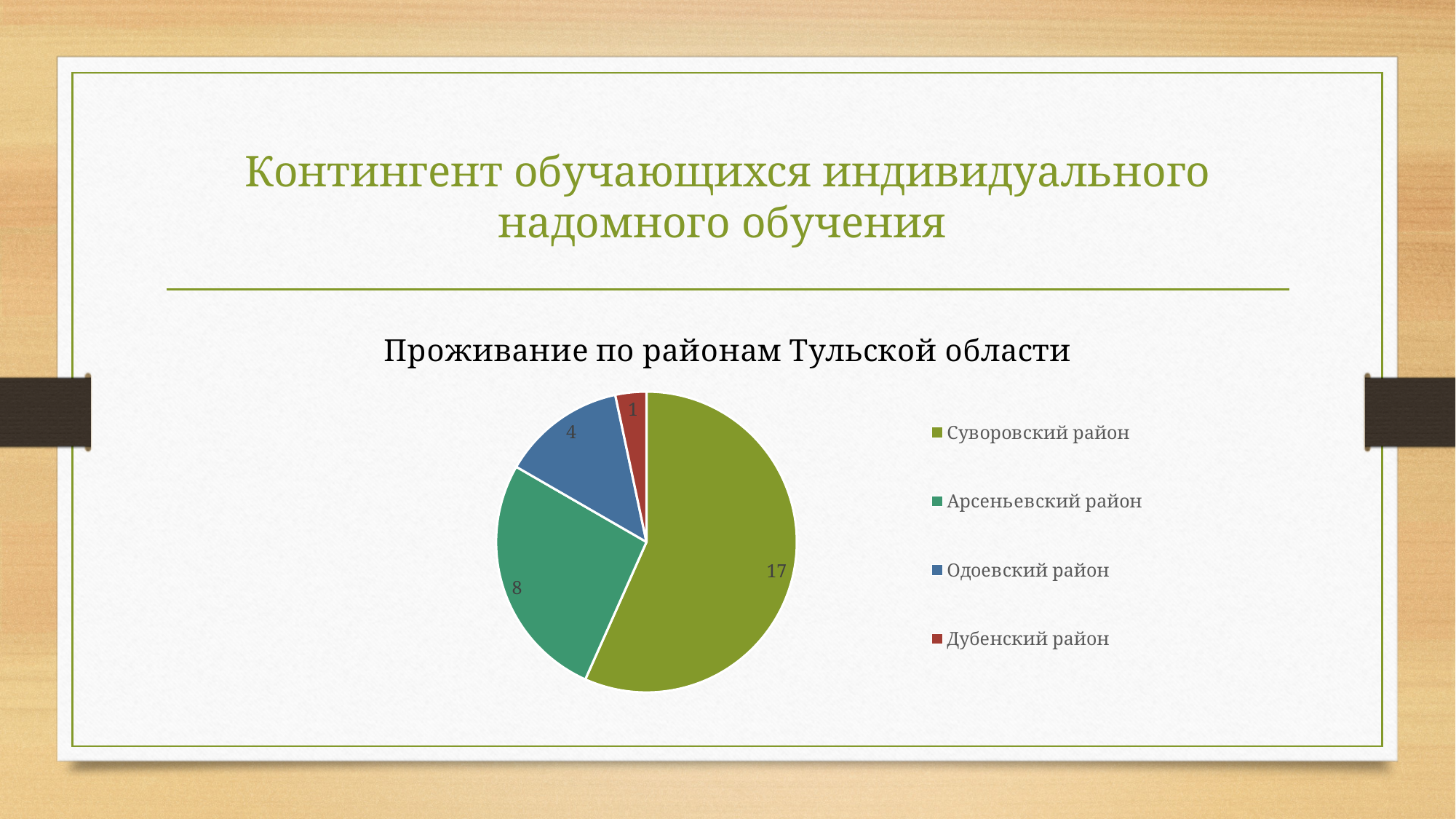
What is the value for Дубенский район? 1 What is the title of the chart? Проживание по районам Тульской области Which district has the smallest slice of the pie? Дубенский район What type of chart is shown on the slide? Pie chart How many districts are shown in the pie chart? 4 What is the value for Арсеньевский район? 8 What is the difference between the values for Суворовский район and Арсеньевский район? 9 Which district has the largest slice of the pie? Суворовский район What is the value for Суворовский район? 17 What is the value for Одоевский район? 4 Which is larger, the value for Одоевский район or the value for Дубенский район? Одоевский район